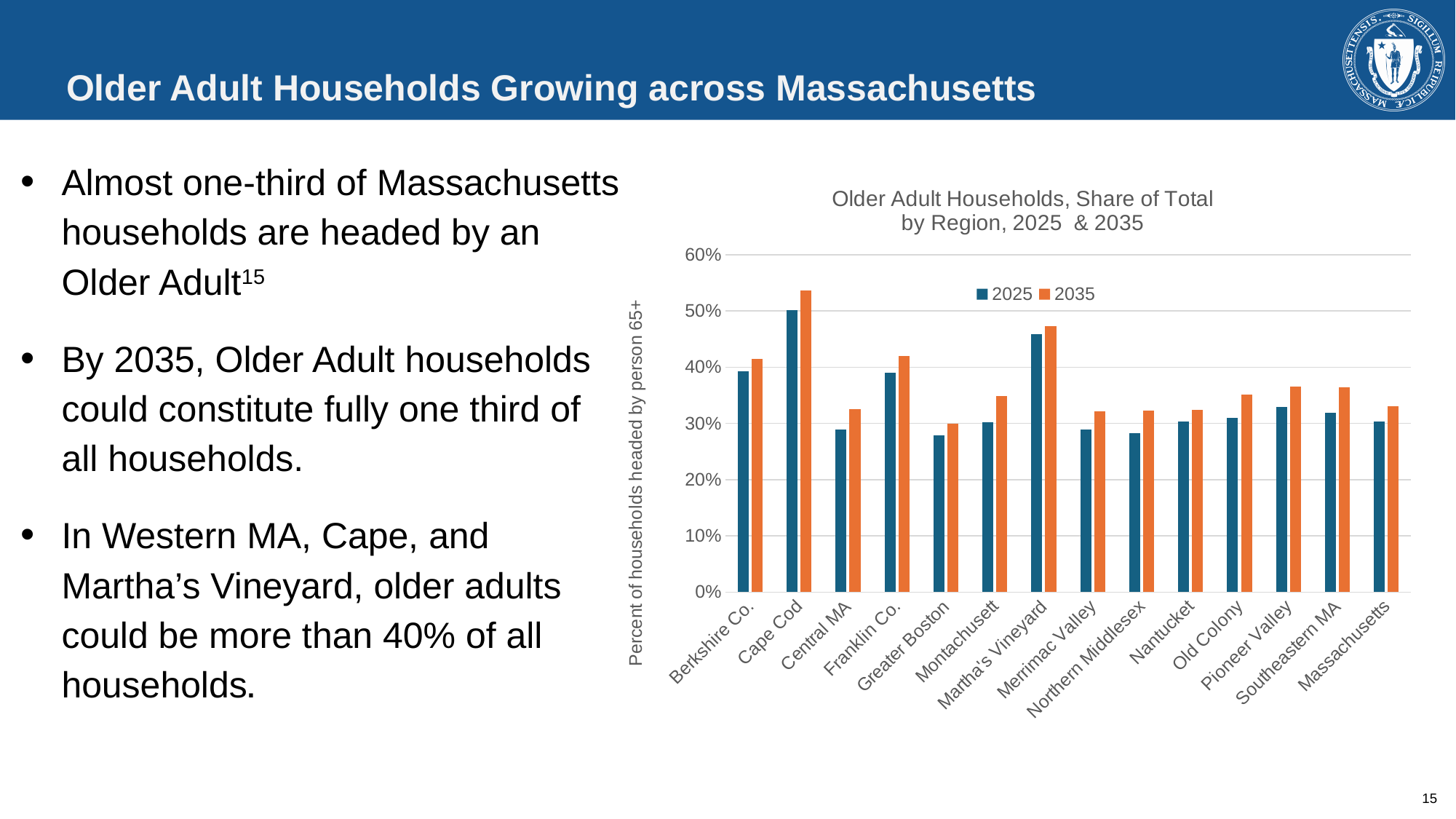
How many regions (categories) are shown on the x axis of the chart? 14 What is the title of the chart? Older Adult Households, Share of Total by Region, 2025 & 2035 Which region has the highest share of older adult households in 2035? Cape Cod How many series does the chart legend list? 2 Which region has the lowest share of older adult households in 2035? Greater Boston What kind of chart is shown on the slide? Bar chart Is the 2035 value for Franklin Co. greater or less than 40%? greater Is the 2035 value for Cape Cod greater or less than 50%? greater Is the 2025 value for Martha's Vineyard greater or less than 40%? greater Which region has the highest share of older adult households in 2025? Cape Cod Which is larger: the 2025 value for Cape Cod or the 2025 value for Martha's Vineyard? Cape Cod